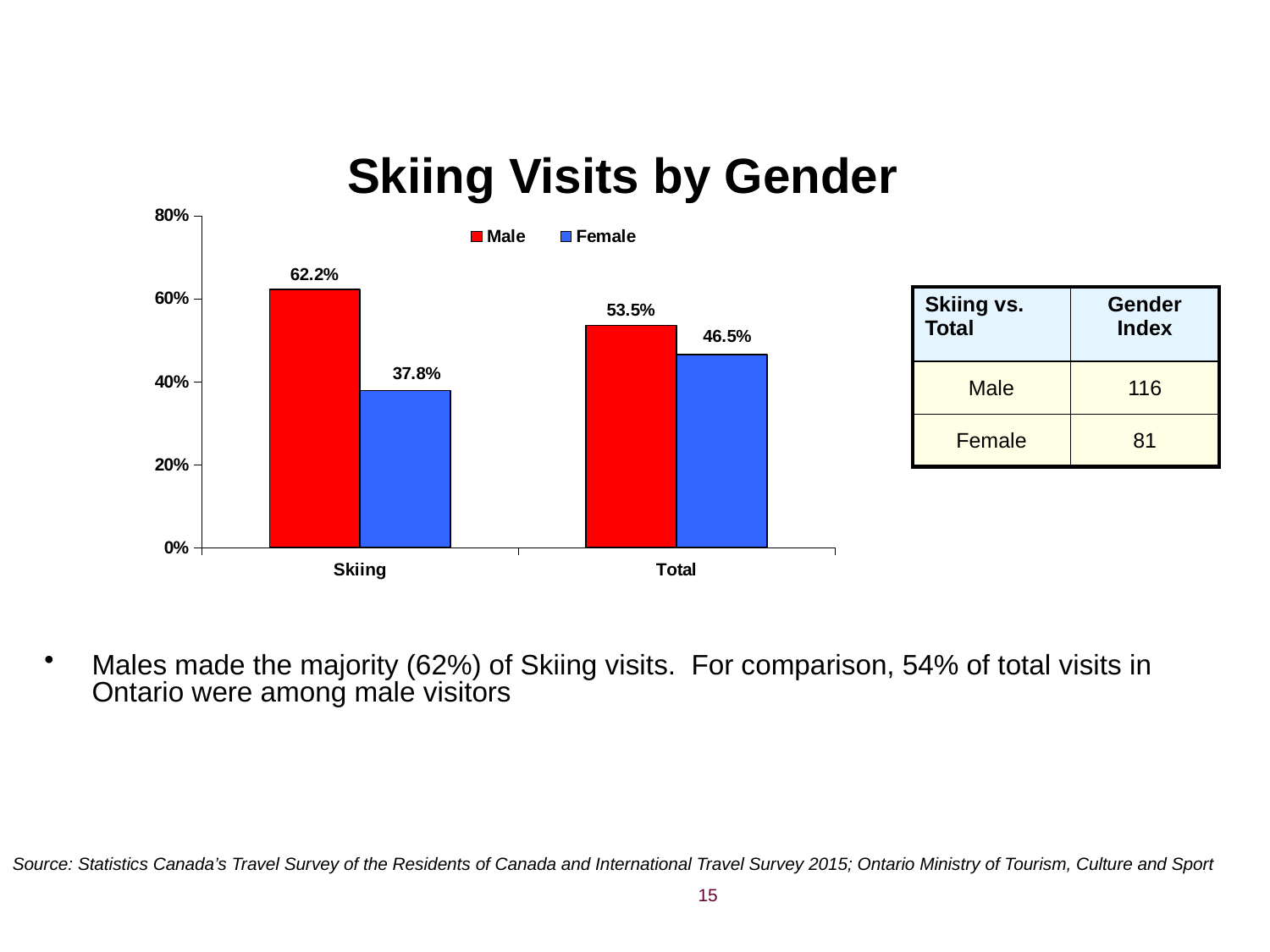
What type of chart is shown on the slide? Bar chart What is the Female value for Skiing? 37.8% What is the Female value for Total? 46.5% What is the Male value for Total? 53.5% Which bar in the chart has the highest value? Male, Skiing How many series does the chart's legend list? 2 What is the difference between the Male and Female values for Skiing? 24.4% Which is larger for Total, the Male value or the Female value? Male Which bar in the chart has the lowest value? Female, Skiing What is the Male value for Skiing? 62.2% What is the difference between the Male value for Skiing and the Male value for Total? 8.7% How many categories are shown on the x axis of the chart? 2